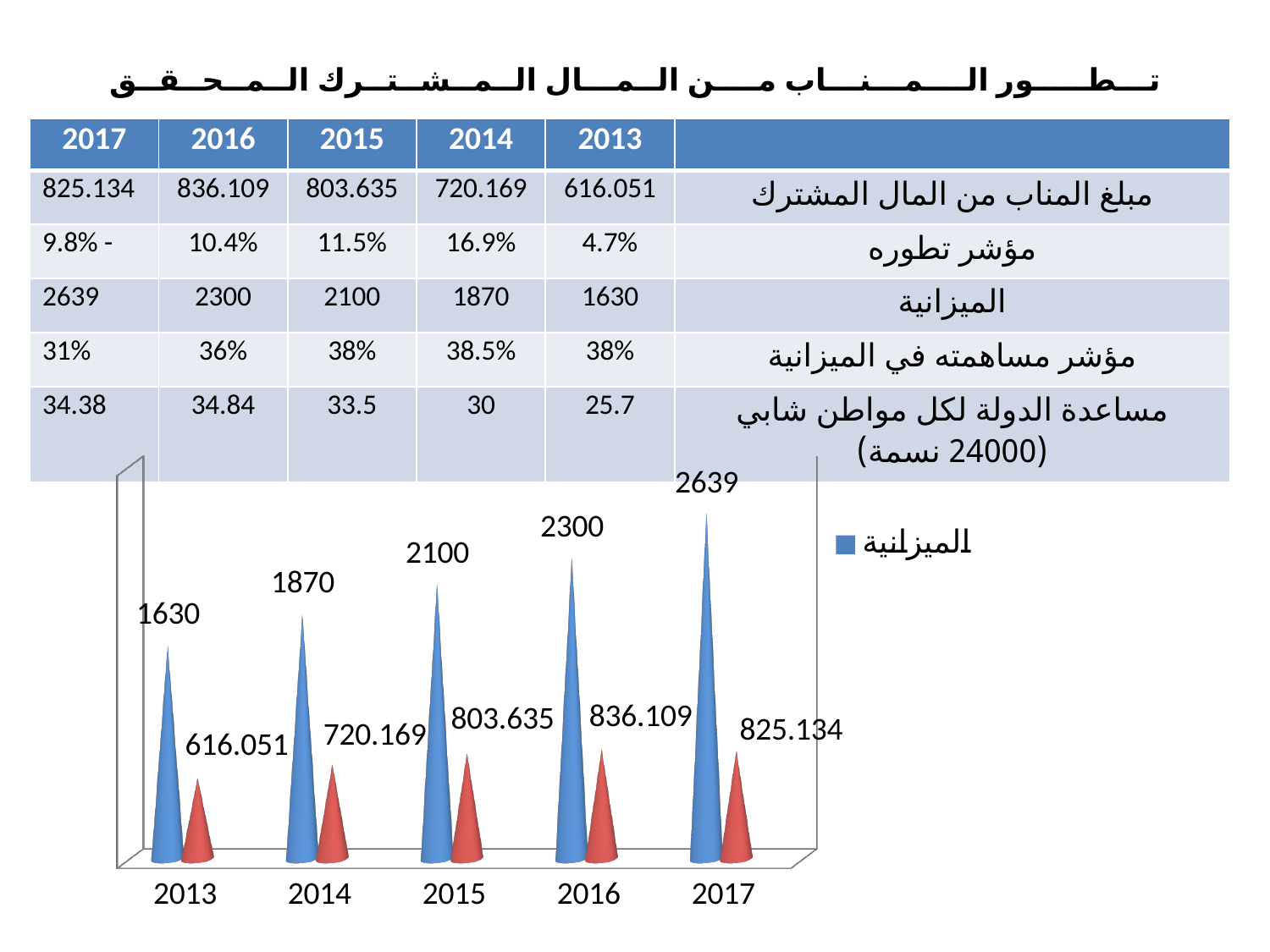
Which is larger in the chart: the red bar for 2016 or the red bar for 2017? 2016 What is the value of the red bar for 2016 in the chart? 836.109 What kind of chart is shown on the slide? bar chart What is the difference between the blue bar values for 2017 and 2016 in the chart? 339 Do the blue bar values rise or fall from 2013 to 2017 in the chart? rise What is the value of the blue bar for 2015 in the chart? 2100 What is the value of the blue bar for 2017 in the chart? 2639 How many years are shown on the x axis of the chart? 5 What is the value of the red bar for 2013 in the chart? 616.051 What is the difference between the red bar values for 2014 and 2013 in the chart? 104.118 Which year has the highest blue bar in the chart? 2017 Which year has the lowest red bar in the chart? 2013